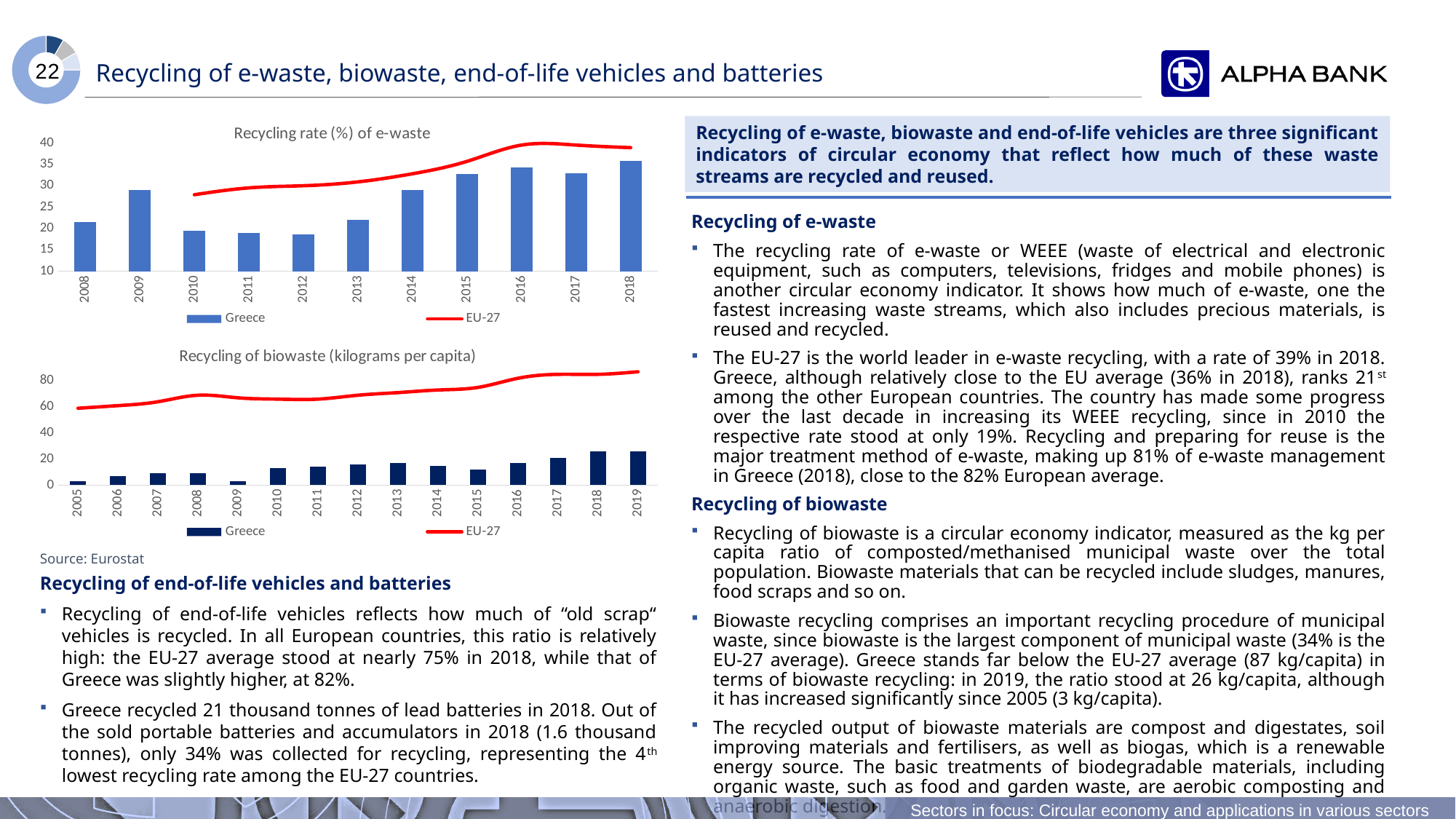
In the 'Recycling rate (%) of e-waste' chart, is the Greece value for 2012 greater or less than 20? less In the 'Recycling rate (%) of e-waste' chart, which year has the highest Greece bar? 2018 In the 'Recycling rate (%) of e-waste' chart, is the EU-27 value for 2016 greater or less than 35? greater In the 'Recycling of biowaste (kilograms per capita)' chart, how many years are shown on the x axis? 15 In the 'Recycling rate (%) of e-waste' chart, which is larger for Greece: 2009 or 2010? 2009 In the 'Recycling rate (%) of e-waste' chart, how many series does the legend list? 2 In the 'Recycling of biowaste (kilograms per capita)' chart, does the EU-27 line generally rise or fall from 2005 to 2019? Rise In the 'Recycling rate (%) of e-waste' chart, is the Greece value for 2009 greater or less than 25? greater In the 'Recycling rate (%) of e-waste' chart, how many years are shown on the x axis? 11 In the 'Recycling of biowaste (kilograms per capita)' chart, which is larger for Greece: 2015 or 2017? 2017 What type of chart is the 'Recycling rate (%) of e-waste' chart? Bar chart with a line